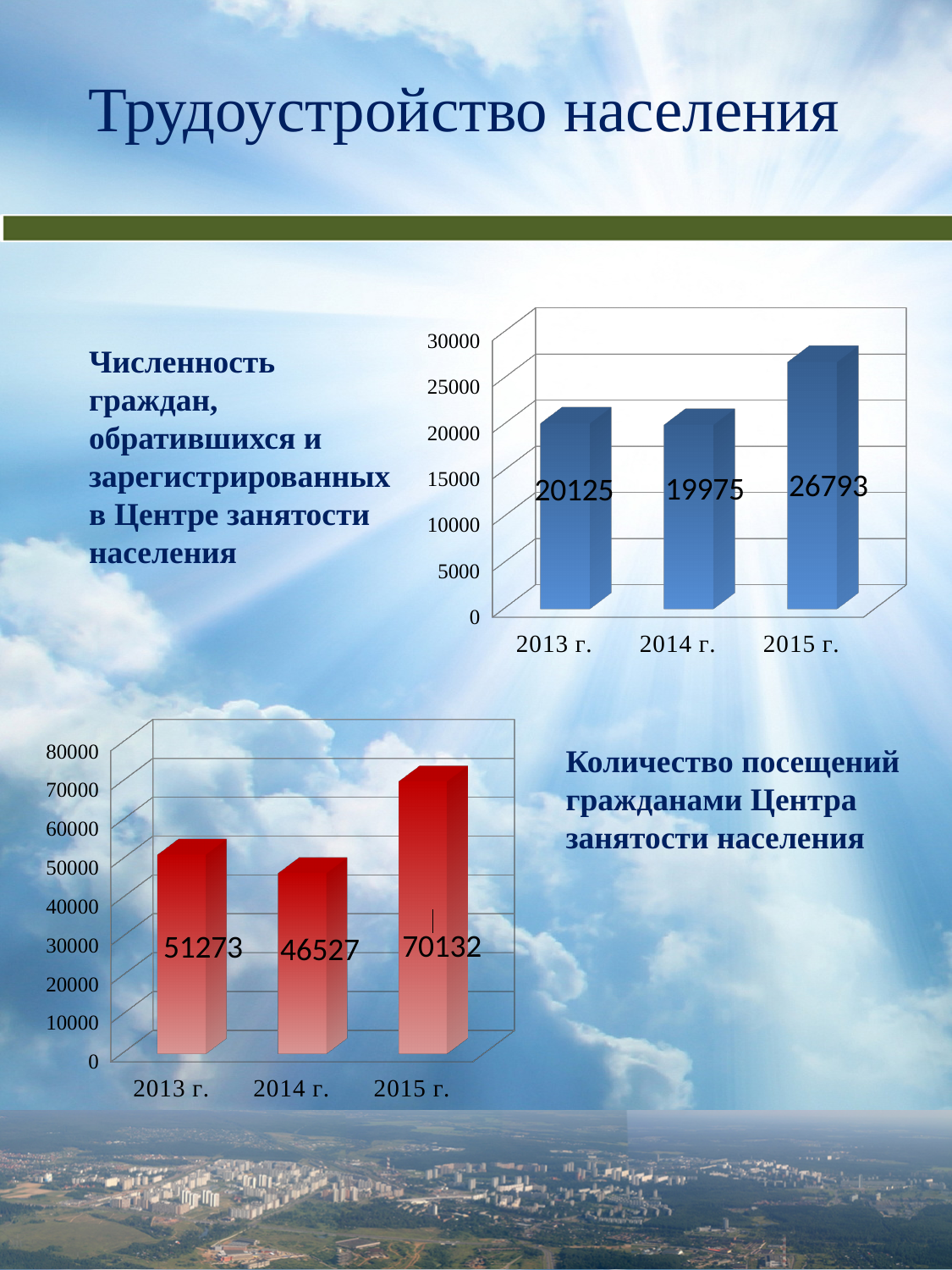
In the bottom chart (Количество посещений гражданами Центра занятости населения), what is the value for 2013 г.? 51273 In the bottom chart (Количество посещений), what is the value for 2015 г.? 70132 In the bottom chart (Количество посещений), what is the difference between the values for 2015 г. and 2014 г.? 23605 In the top chart (Численность граждан), which year has the highest value? 2015 г. In the bottom chart (Количество посещений), which is larger, the value for 2013 г. or 2014 г.? 2013 г. How many years are shown on the x axis of the bottom chart (Количество посещений)? 3 In the top chart (Численность граждан), what is the difference between the values for 2015 г. and 2013 г.? 6668 In the bottom chart (Количество посещений), which year has the lowest value? 2014 г. In the top chart (Численность граждан), what is the value for 2015 г.? 26793 In the top chart (Численность граждан), is the value for 2015 г. greater or less than 25000? greater What type of chart is the top chart (Численность граждан)? bar chart In the top chart (Численность граждан, обратившихся и зарегистрированных в Центре занятости населения), what is the value for 2014 г.? 19975